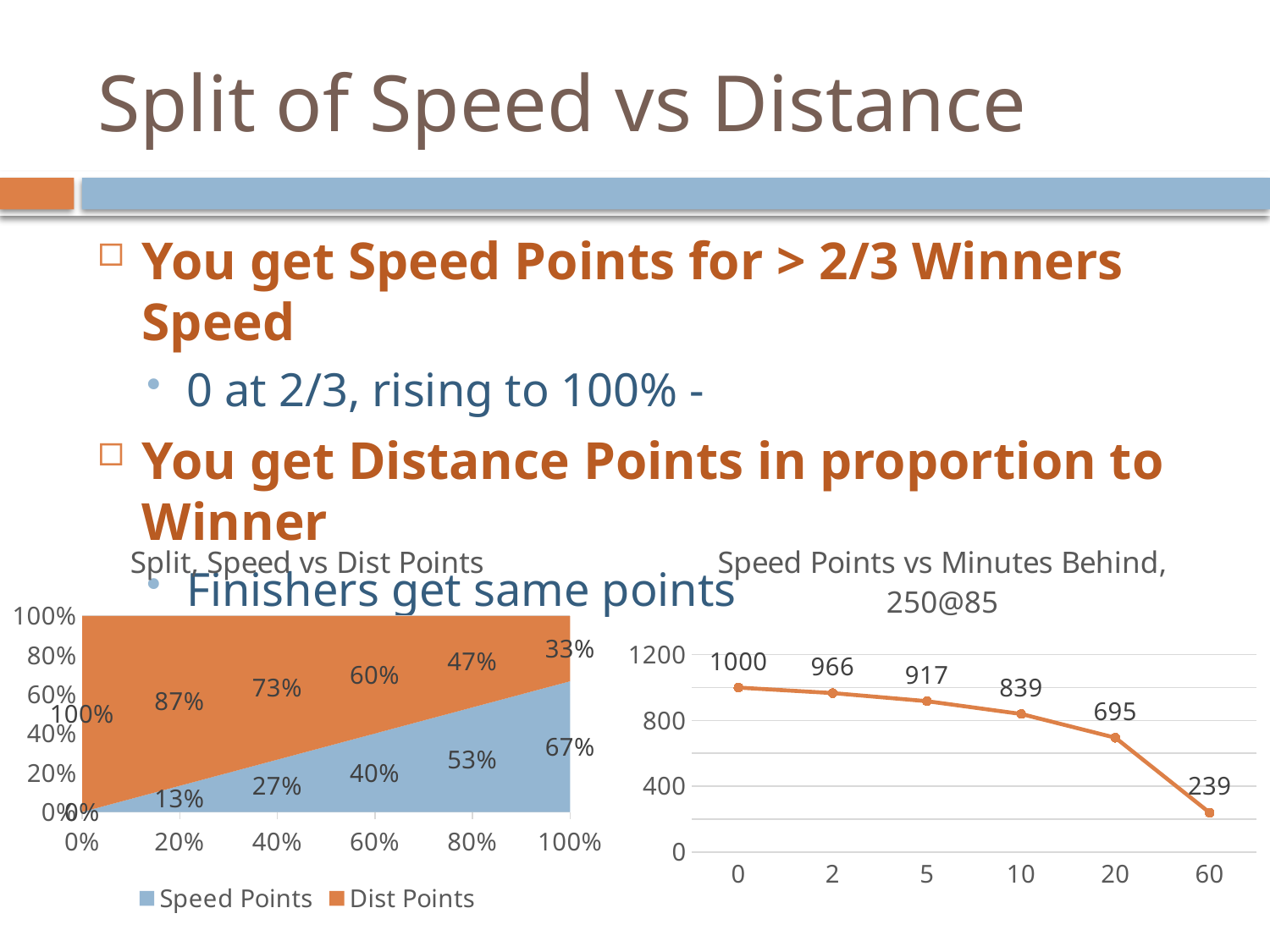
In the 'Split, Speed vs Dist Points' chart, what is the Speed Points value at 60%? 40% In the 'Split, Speed vs Dist Points' chart, what is the Dist Points value at 20%? 87% In the 'Speed Points vs Minutes Behind, 250@85' chart, what is the value at 60 minutes behind? 239 In the 'Split, Speed vs Dist Points' chart, which is larger at 80%: Speed Points or Dist Points? Speed Points How many data points are plotted in the 'Speed Points vs Minutes Behind, 250@85' chart? 6 In the 'Speed Points vs Minutes Behind, 250@85' chart, which x-axis category has the highest value? 0 In the 'Speed Points vs Minutes Behind, 250@85' chart, what is the value at 10 minutes behind? 839 How many series does the legend of the 'Split, Speed vs Dist Points' chart list? 2 What kind of chart is 'Speed Points vs Minutes Behind, 250@85'? line chart In the 'Split, Speed vs Dist Points' chart, what is the difference between Dist Points and Speed Points at 100%? 34% In the 'Speed Points vs Minutes Behind, 250@85' chart, what is the difference between the values at 0 and 2 minutes behind? 34 In the 'Speed Points vs Minutes Behind, 250@85' chart, do the values rise or fall as minutes behind increases? fall